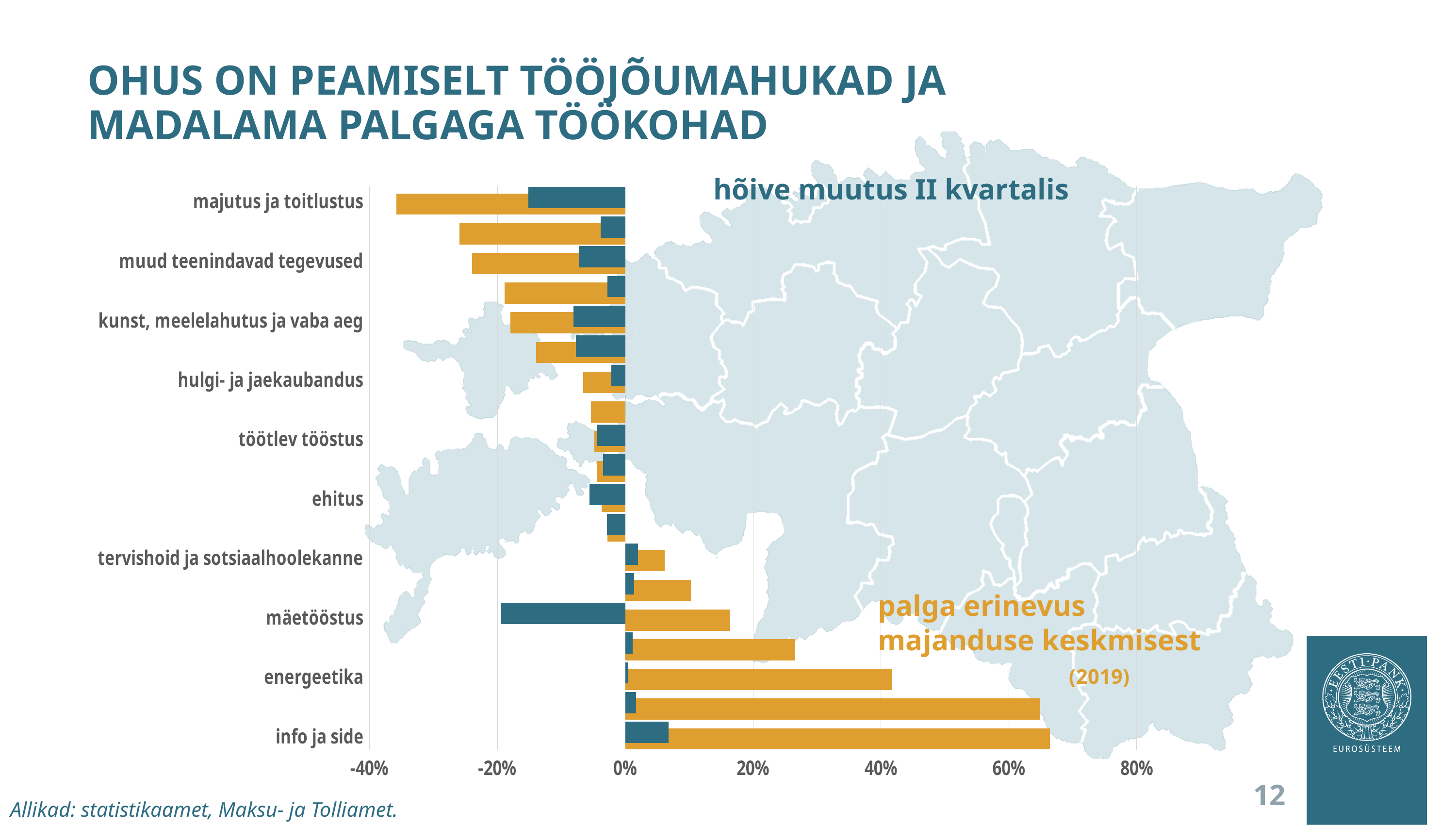
What colour are the bars for the hõive muutus II kvartalis series? teal (dark blue) Is the palga erinevus majanduse keskmisest value for energeetika greater or less than 20%? greater Is the palga erinevus majanduse keskmisest value for majutus ja toitlustus greater or less than -20%? less Is the palga erinevus majanduse keskmisest value for mäetööstus greater or less than 20%? less Which category has the lowest (most negative) value for palga erinevus majanduse keskmisest? majutus ja toitlustus Which labelled category has the lowest (most negative) value for hõive muutus II kvartalis? mäetööstus Which has the larger palga erinevus majanduse keskmisest value, info ja side or energeetika? info ja side Which labelled category has the highest value for hõive muutus II kvartalis? info ja side Do the palga erinevus majanduse keskmisest values increase or decrease going from the top category to the bottom category? increase How many data series does the chart show? 2 What kind of chart is shown on the slide? bar chart